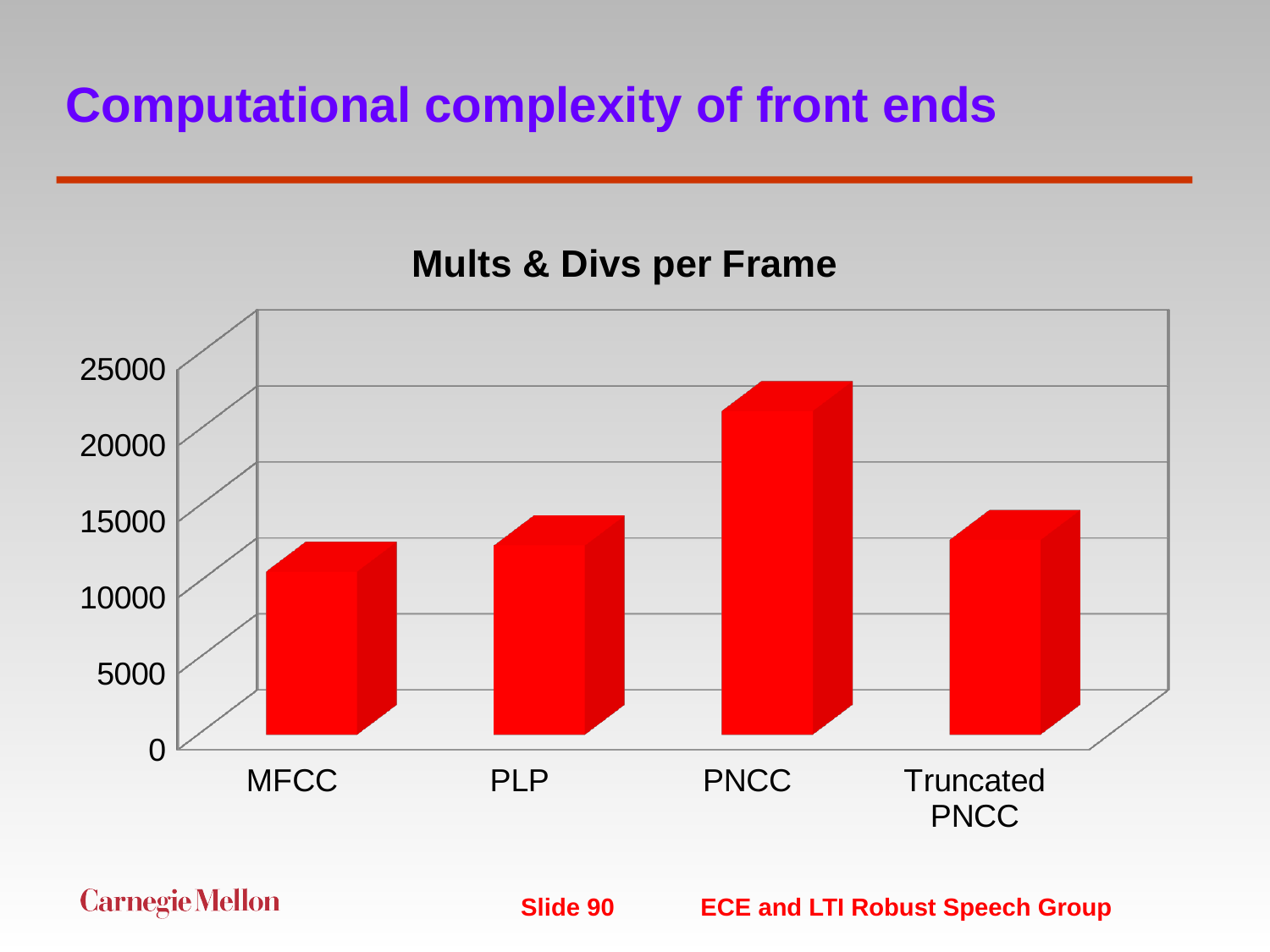
Which is larger, the value for MFCC or the value for PLP? PLP Is the value for PNCC greater or less than 20000? greater Which front end has the highest number of mults & divs per frame? PNCC Which front end has the lowest number of mults & divs per frame? MFCC Is the value for PLP greater or less than 15000? less Is the value for MFCC greater or less than 10000? greater Which is larger, the value for PNCC or the value for Truncated PNCC? PNCC How many front ends (categories) are shown on the x axis? 4 What kind of chart is shown on the slide? bar chart What is the title of the chart? Mults & Divs per Frame